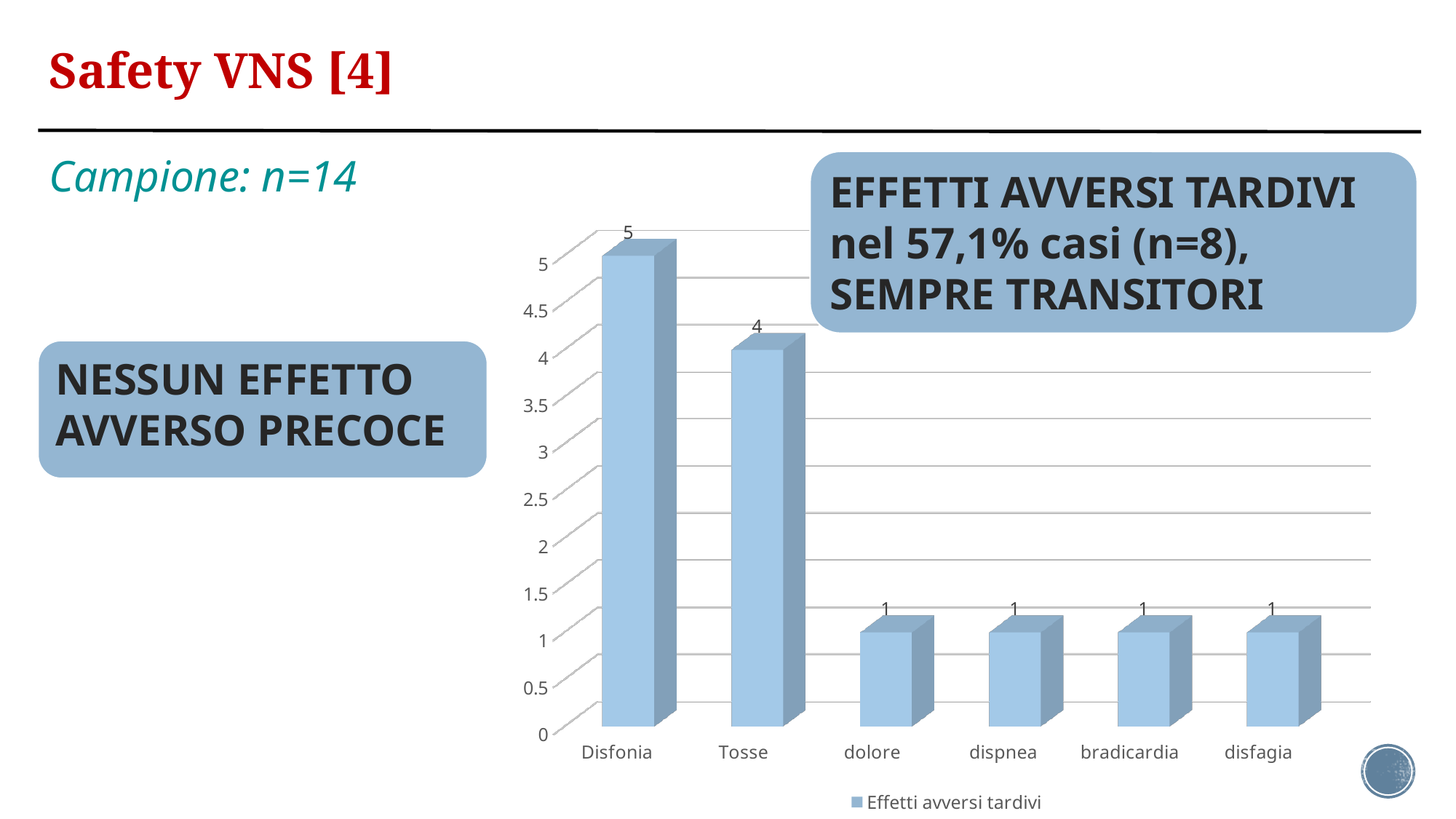
What is the difference between the values for Disfonia and Tosse? 1 What is the value for Tosse? 4 What is the value for Disfonia? 5 What kind of chart is shown on the slide? bar chart What is the difference between the values for Tosse and dispnea? 3 How many categories are shown on the x axis? 6 Which is larger, the value for Tosse or the value for dolore? Tosse What is the legend entry for the series shown? Effetti avversi tardivi Is the value for Disfonia greater or less than 4.5? greater How many series does the legend list? 1 What is the value for bradicardia? 1 Which category has the highest value? Disfonia